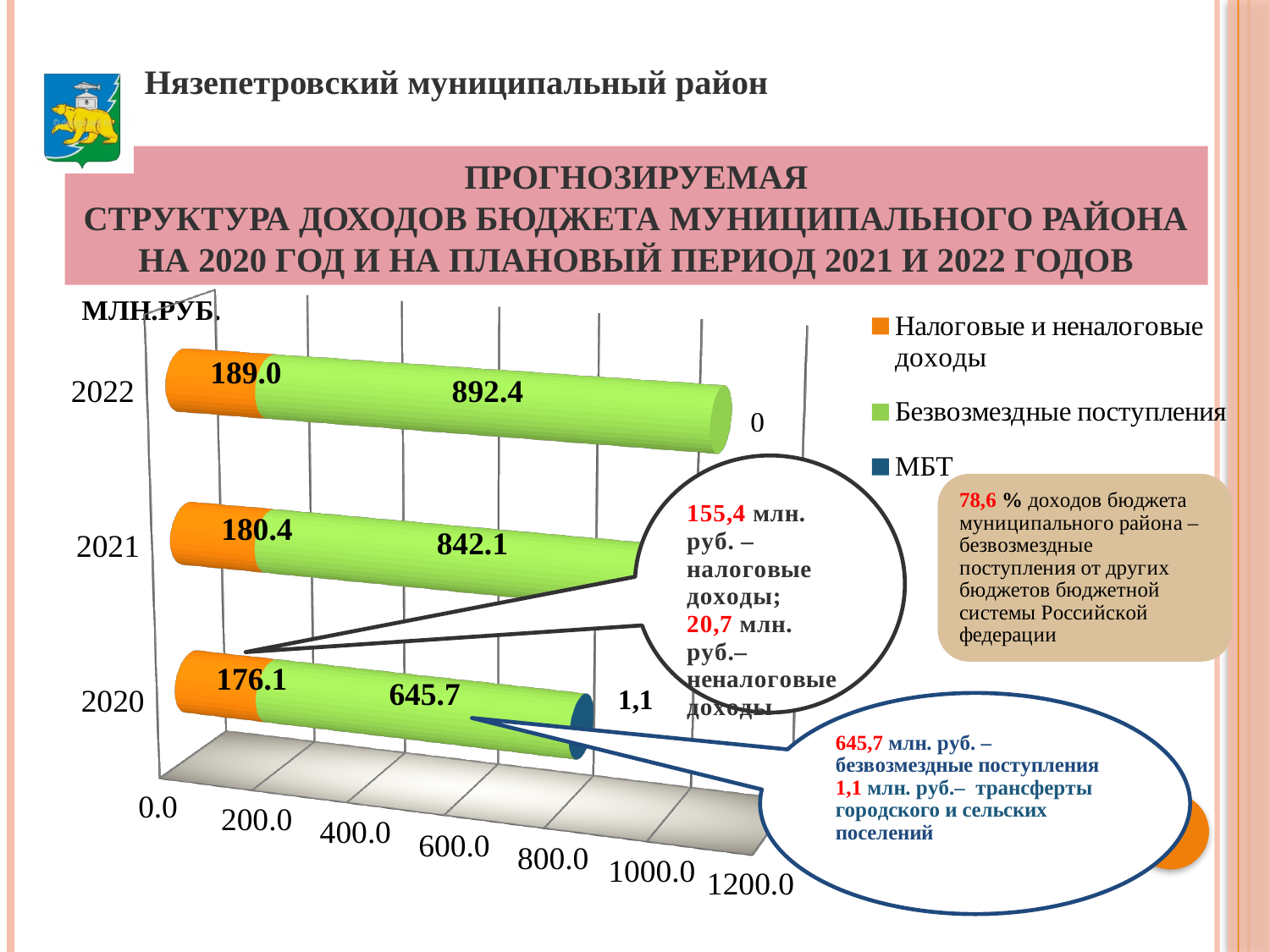
What is the value of Безвозмездные поступления for 2020? 645.7 What is the value of Налоговые и неналоговые доходы for 2022? 189.0 Which year has the lowest value of Налоговые и неналоговые доходы? 2020 How many series does the legend list? 3 Which year has the highest value of Безвозмездные поступления? 2022 What kind of chart is shown on the slide? Stacked bar chart What is the value of МБТ for 2020? 1,1 Which is larger: Налоговые и неналоговые доходы in 2021 or in 2020? 2021 What is the value of Безвозмездные поступления for 2021? 842.1 How many years are shown on the chart? 3 What is the difference between Безвозмездные поступления in 2022 and 2021? 50.3 Do the values of Безвозмездные поступления rise or fall from 2020 to 2022? Rise